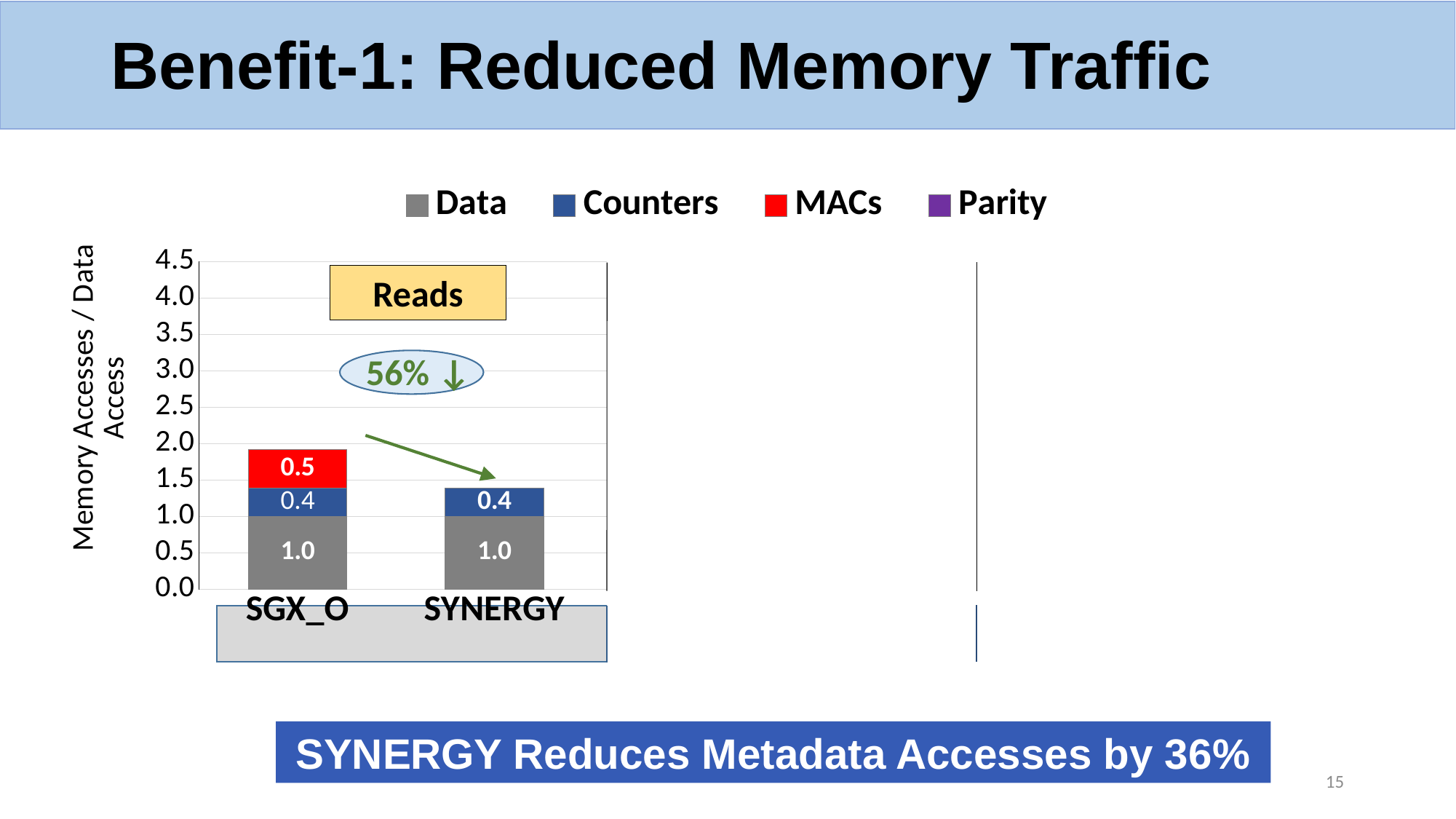
What is the total of the stacked bar for SGX_O? 1.9 What is the y-axis label of the chart? Memory Accesses / Data Access What is the Data value for SGX_O? 1.0 What kind of chart is shown? Stacked bar chart What is the difference between the MACs value for SGX_O and the Counters value for SGX_O? 0.1 How many categories are shown on the x axis? 2 What is the Counters value for SYNERGY? 0.4 What is the MACs value for SGX_O? 0.5 Is the total stacked bar for SGX_O greater or less than 2.0? less Which category has the higher total stacked bar, SGX_O or SYNERGY? SGX_O How many series does the legend list? 4 What is the total of the stacked bar for SYNERGY? 1.4